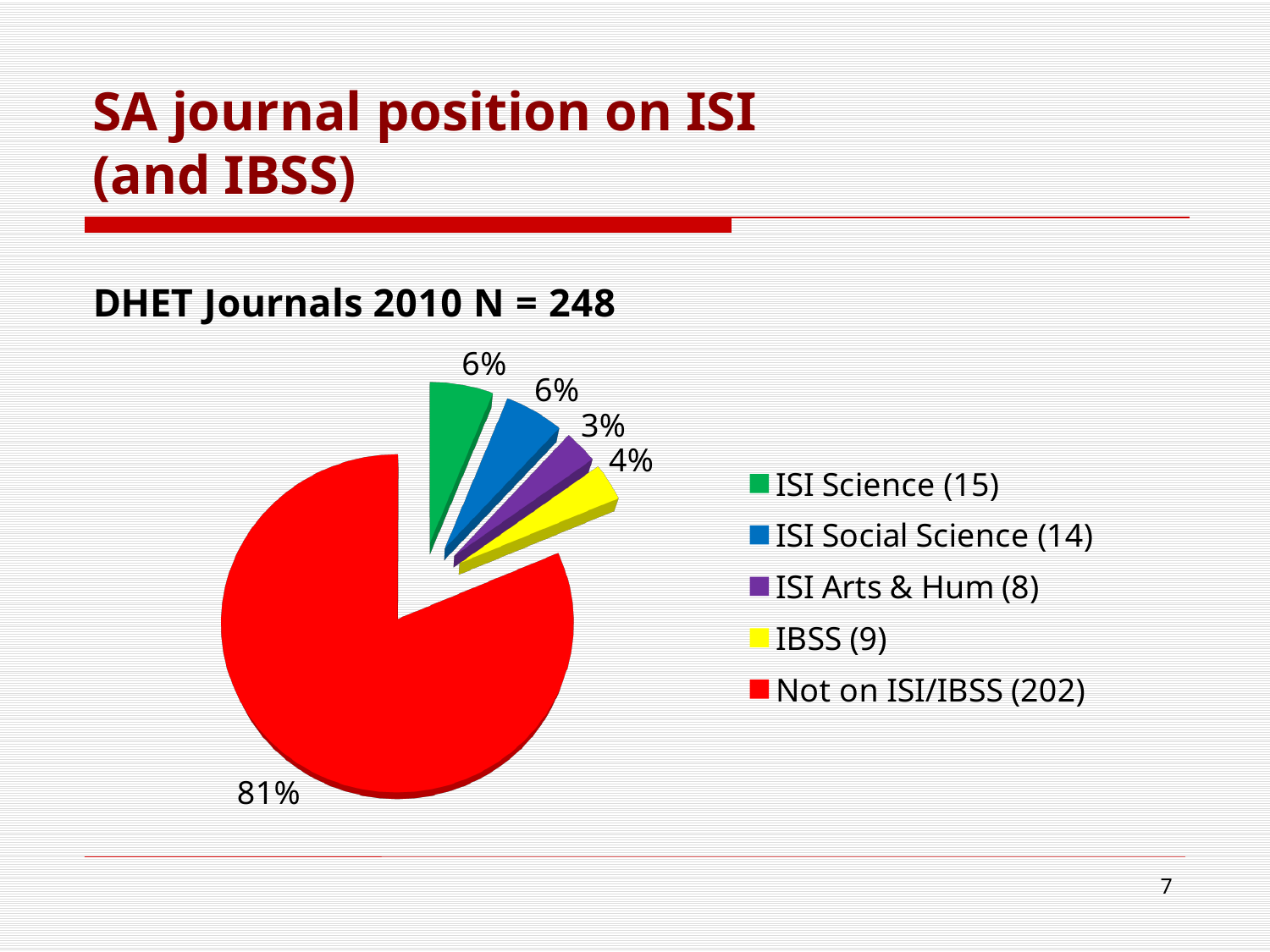
How many slices does the pie chart have? 5 What share of the pie is ISI Arts & Hum? 3% How many more journals are Not on ISI/IBSS than in ISI Science? 187 What is the title of the chart? DHET Journals 2010 N = 248 How many journals are in the IBSS category according to the legend? 9 Which category has the smallest slice of the pie? ISI Arts & Hum How many journals are in the ISI Science category according to the legend? 15 What kind of chart is shown on the slide? pie chart Which category has the largest slice of the pie? Not on ISI/IBSS What share of the pie is Not on ISI/IBSS? 81% Which category has more journals, ISI Science or IBSS? ISI Science What share of the pie is IBSS? 4%